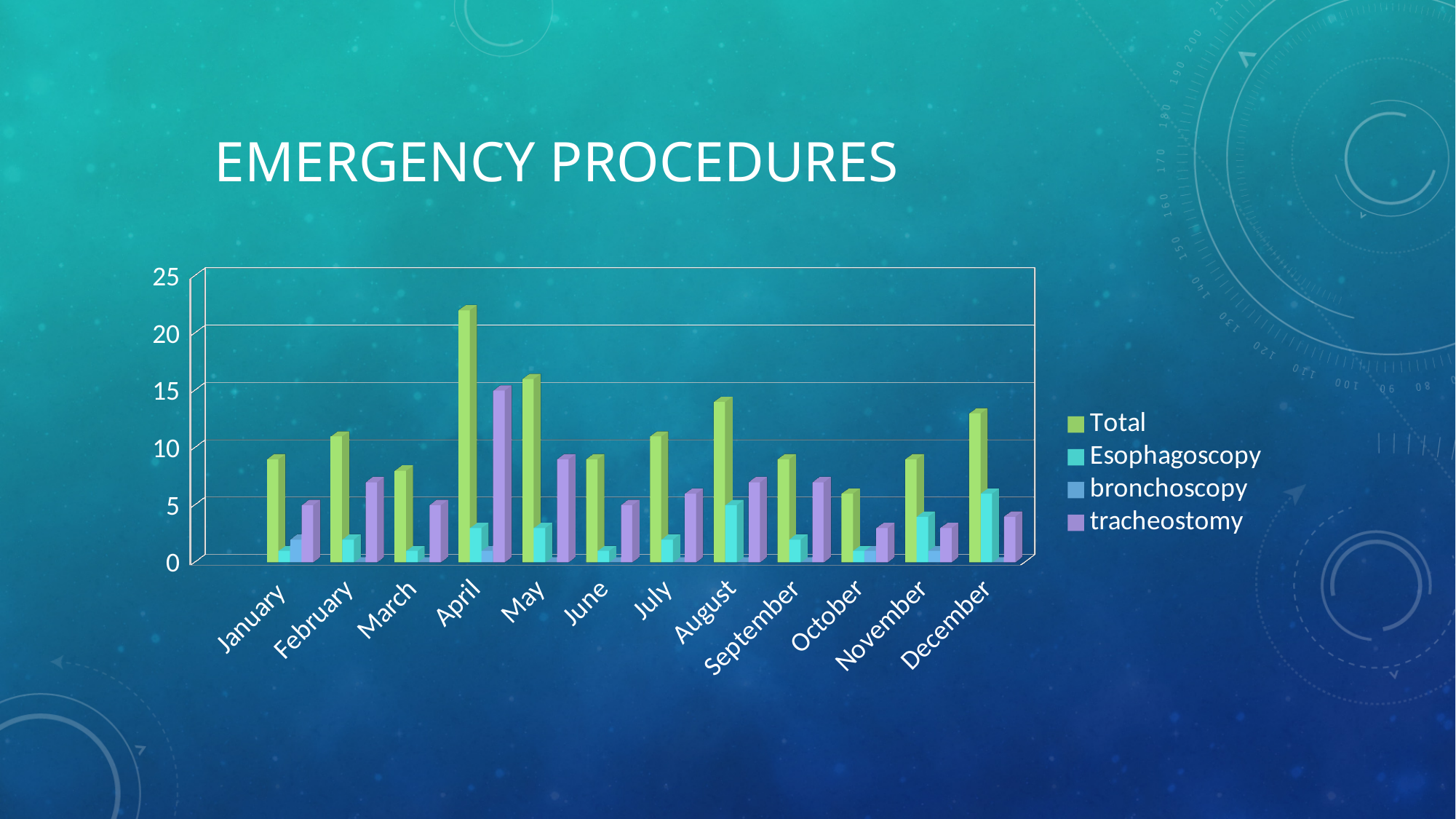
In which month is the tracheostomy value highest? April What is the title of the chart on the slide? Emergency Procedures Is the Esophagoscopy value for January greater or less than 5? less In which month is the Total value highest? April How many series does the legend list? 4 Is the tracheostomy value for April greater or less than 10? greater Is the Total value for April greater or less than 20? greater What kind of chart is shown on the slide? bar chart In which month is the Total value lowest? October How many months are shown on the x axis? 12 Which is larger, the Total value for April or the Total value for May? April